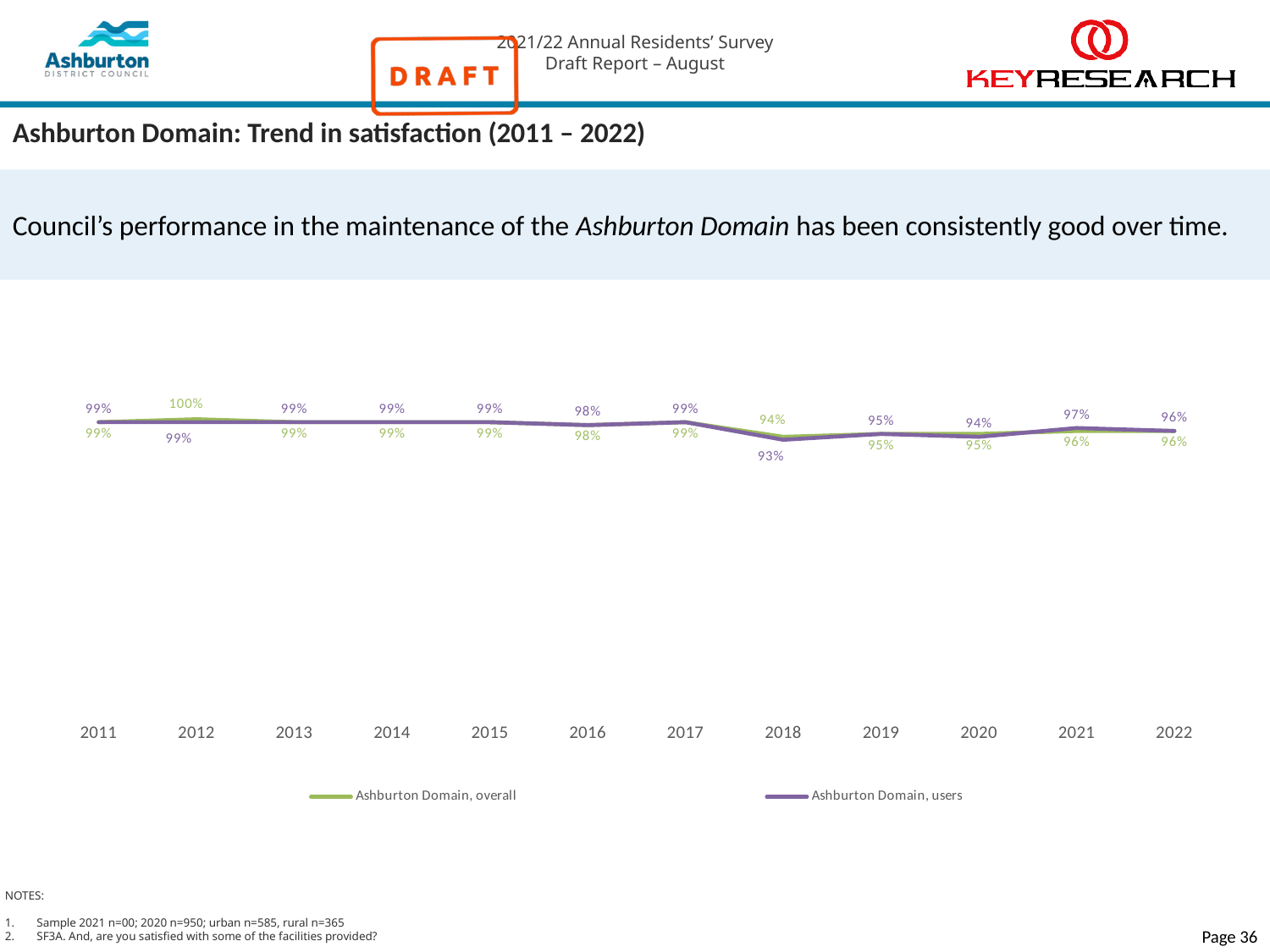
What is the value for Ashburton Domain, users in 2018? 93% What is the value for Ashburton Domain, overall in 2011? 99% What is the value for Ashburton Domain, users in 2016? 98% What is the value for Ashburton Domain, overall in 2012? 100% In which year is the Ashburton Domain, overall series at its highest? 2012 Did the Ashburton Domain, users value rise or fall from 2017 to 2018? Fall In which year is the Ashburton Domain, users series at its lowest? 2018 What type of chart is shown on the slide? Line chart How many series does the chart legend list? 2 What are the two series named in the chart legend? Ashburton Domain, overall and Ashburton Domain, users How many years are plotted along the x axis of the chart? 12 What is the value for Ashburton Domain, overall in 2022? 96%